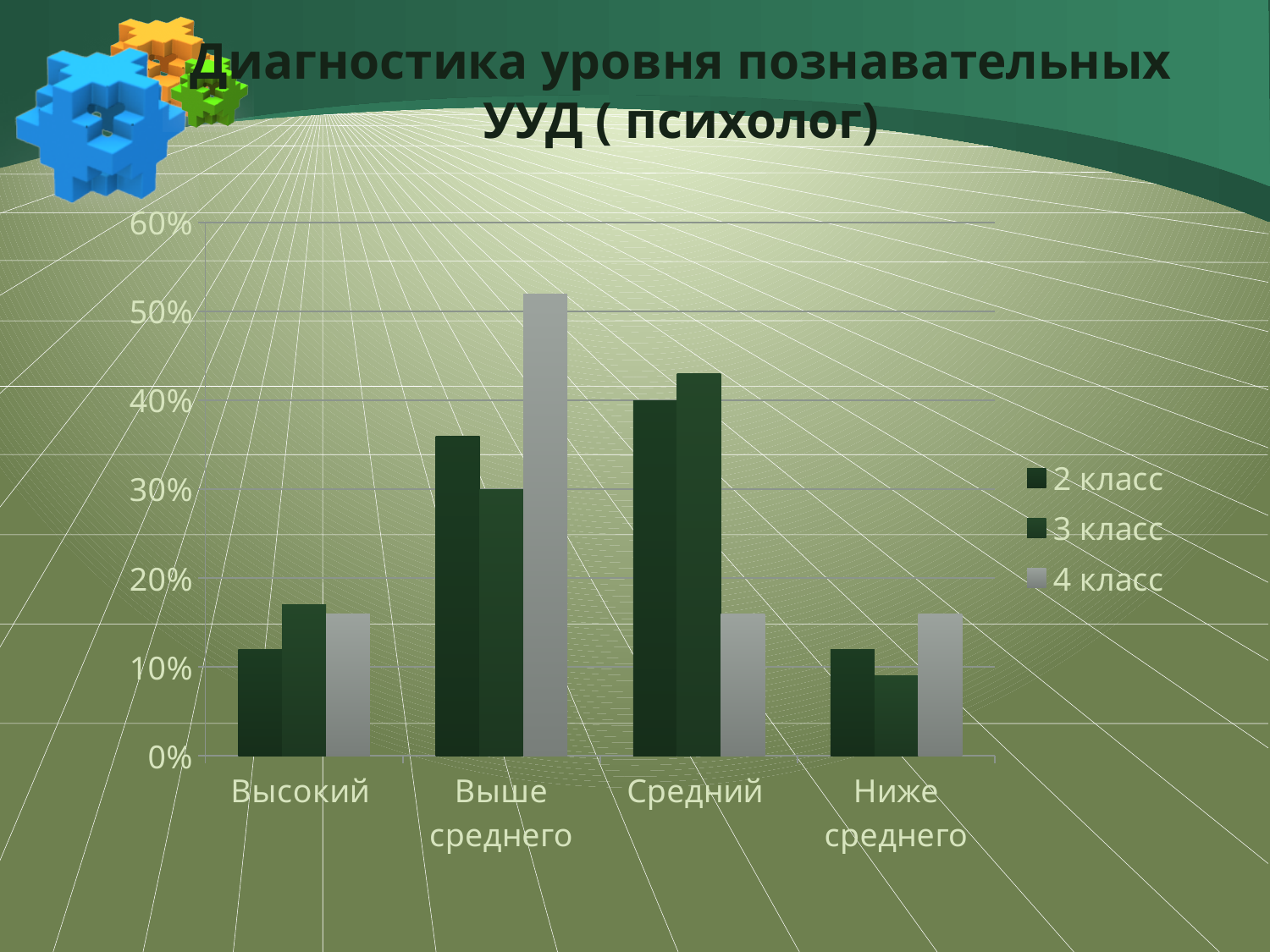
For the series 3 класс, which category has the lowest value? Ниже среднего What is the title of the chart on the slide? Диагностика уровня познавательных УУД ( психолог) What kind of chart is shown on the slide? bar chart Is the value for 4 класс in the category Выше среднего greater or less than 50%? greater How many categories are shown on the x axis of the chart? 4 How many series does the chart's legend list? 3 In the category Выше среднего, which is larger: the value for 2 класс or the value for 3 класс? 2 класс Is the value for 3 класс in the category Средний greater or less than 40%? greater In the category Средний, which is larger: the value for 3 класс or the value for 4 класс? 3 класс For the series 4 класс, which category has the highest value? Выше среднего Which series has the tallest bar in the whole chart? 4 класс